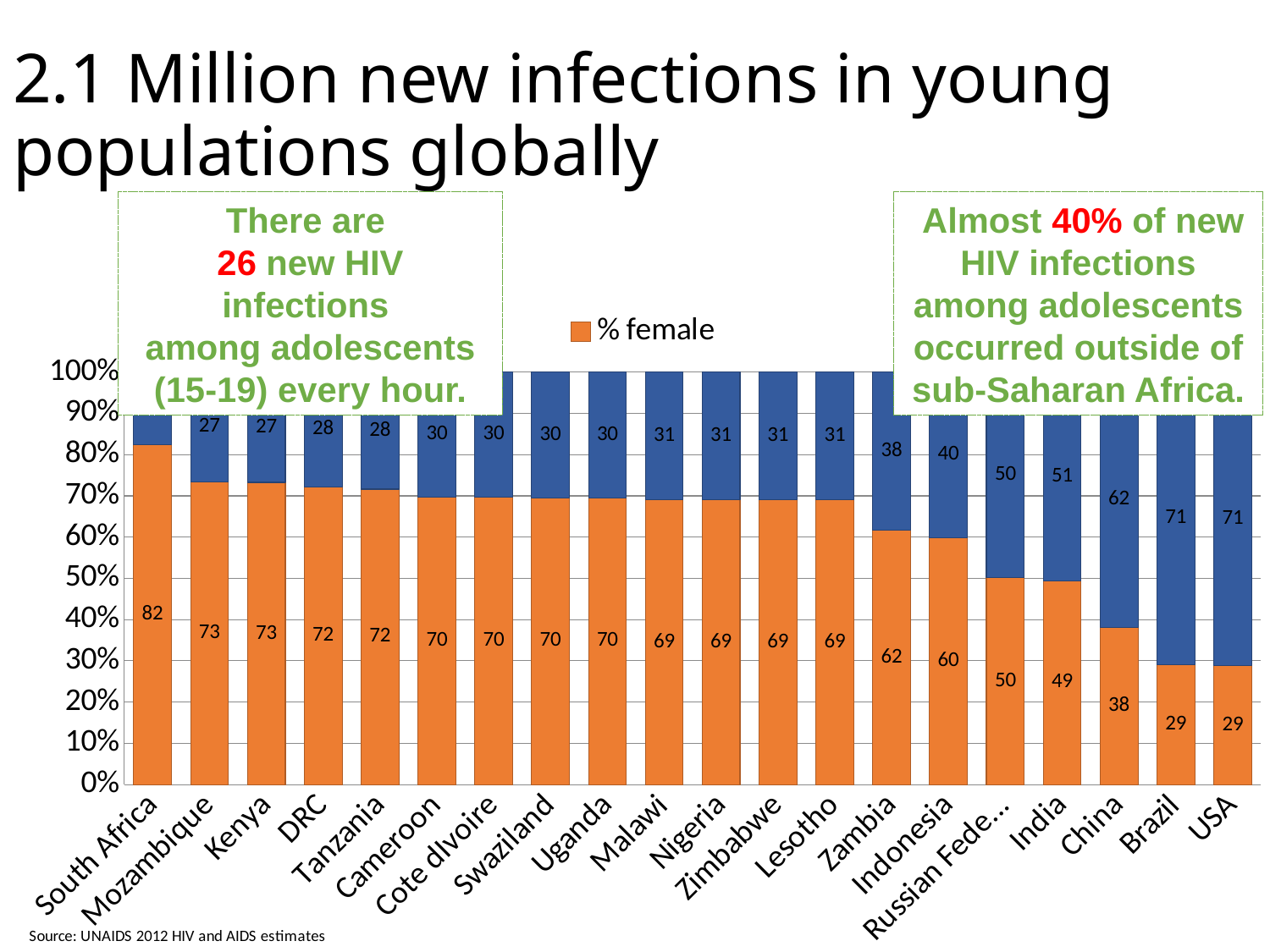
What legend entry is visible for the orange series? % female Which country has the highest value in the blue (upper) segment among those with a printed label? Brazil and USA (71) What is the total of the stacked bar for Kenya (73 + 27)? 100 How many countries are shown on the x axis? 20 Which country has the highest % female value? South Africa What kind of chart is shown on the slide? Stacked bar chart What is the value of the blue (upper) segment for China? 62 What is the difference between the % female values for South Africa and Brazil? 53 What is the % female value for South Africa? 82 Do the % female values generally rise or fall moving from left to right along the x axis? Fall Which has a larger % female value, India or China? India What is the % female value for Indonesia? 60